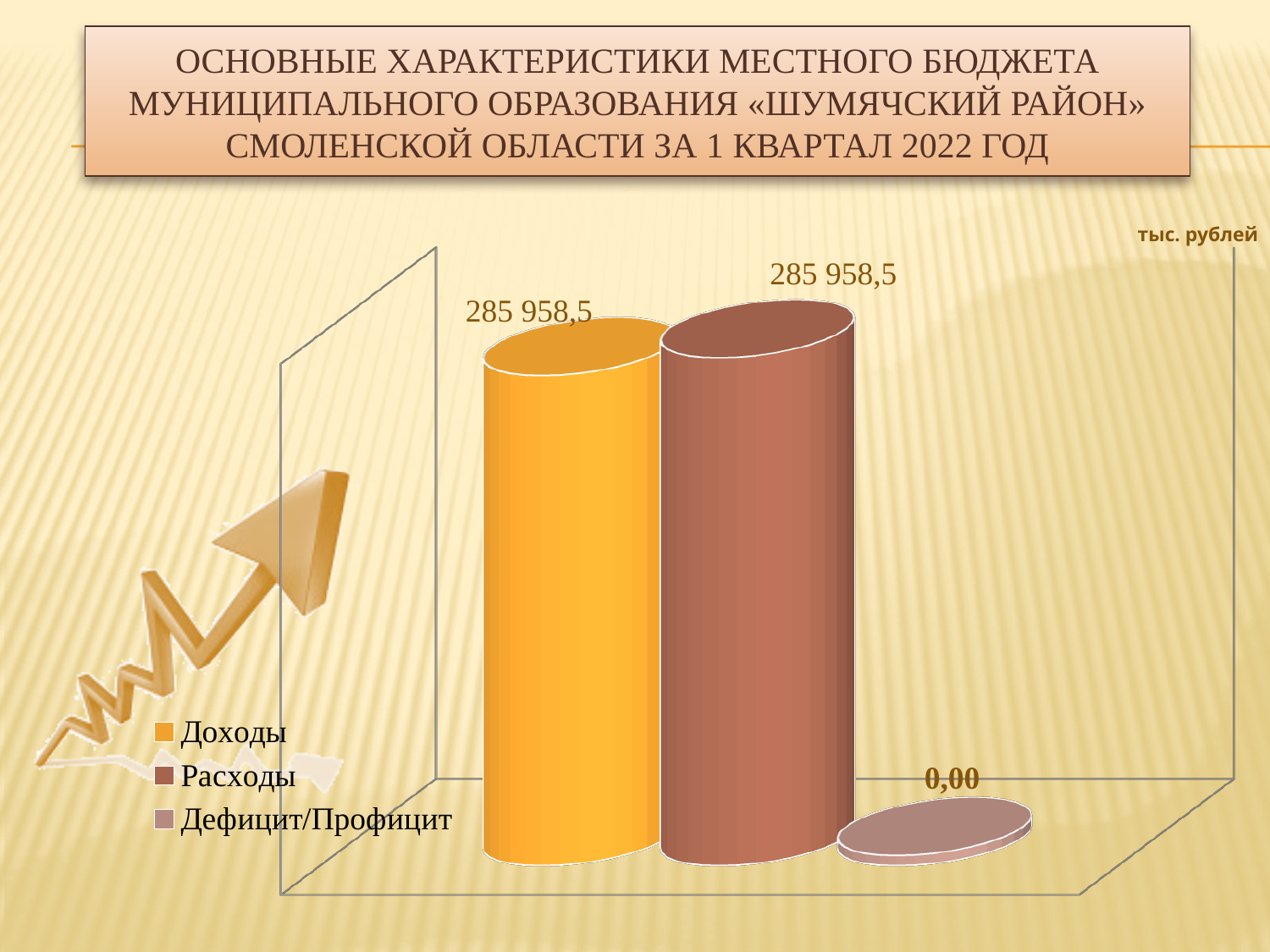
What is the value for Расходы? 285 958,5 Is the value for Доходы larger than, smaller than, or equal to the value for Расходы? equal What is the value for Доходы? 285 958,5 What is the value for Дефицит/Профицит? 0,00 How many bars are plotted on the chart? 3 What unit of measurement is indicated on the chart? тыс. рублей What is the difference between the values for Доходы and Расходы? 0,0 Is the value for Расходы greater or less than the value for Дефицит/Профицит? greater Which series has the lowest value? Дефицит/Профицит What kind of chart is shown on the slide? bar chart Which legend entry is shown in orange? Доходы How many series does the legend list? 3